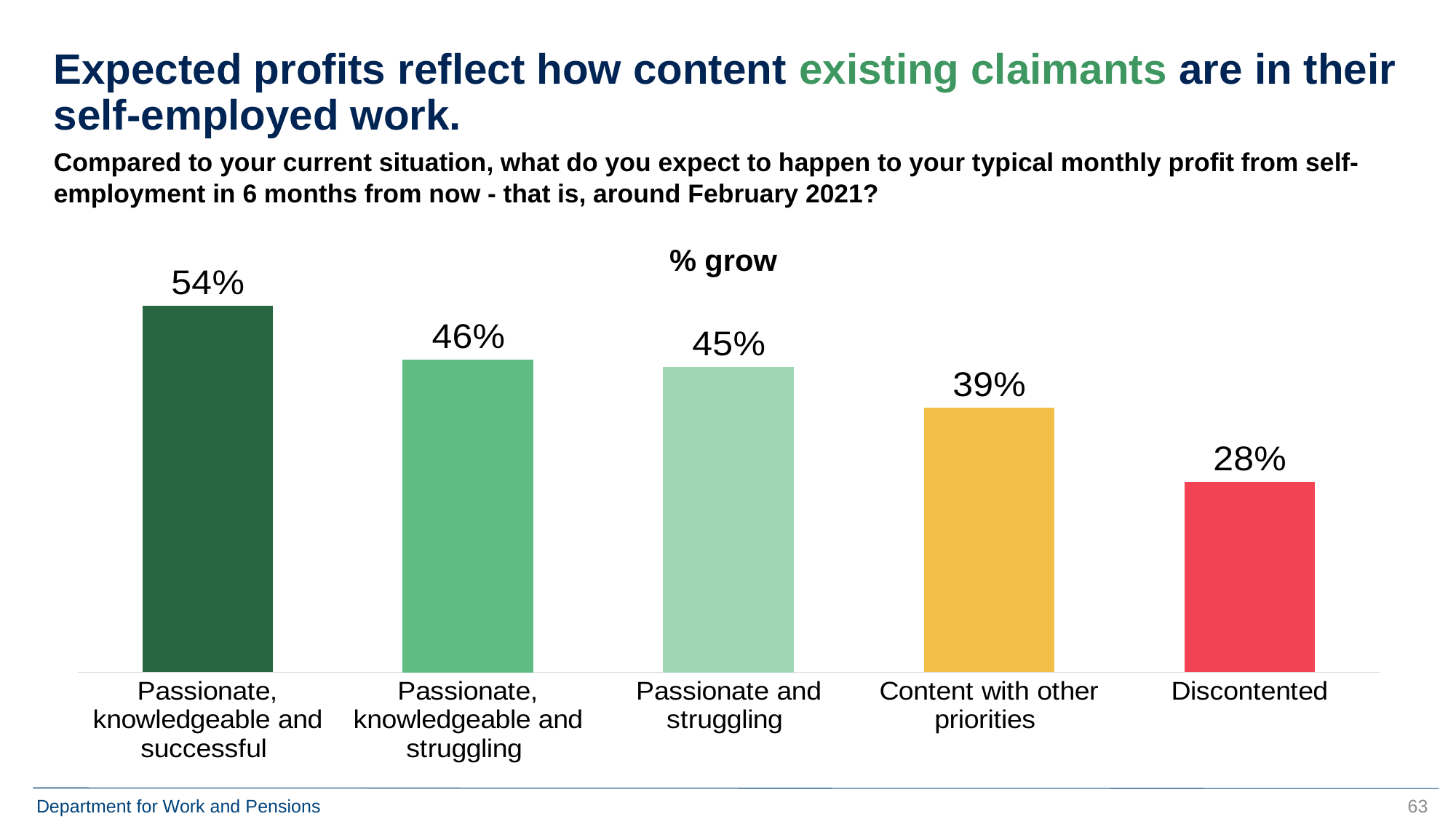
Which is larger, the value for 'Content with other priorities' or the value for 'Discontented'? Content with other priorities What is the value for 'Passionate and struggling'? 45% What is the difference between the values for 'Passionate, knowledgeable and struggling' and 'Content with other priorities'? 7% What is the difference between the values for 'Passionate, knowledgeable and successful' and 'Discontented'? 26% What is the title of the chart? % grow Which category has the lowest value? Discontented What is the value for 'Content with other priorities'? 39% What is the value for 'Discontented'? 28% What kind of chart is shown on the slide? Bar chart What is the value for 'Passionate, knowledgeable and successful'? 54% How many categories are shown in the chart? 5 Which category has the highest value? Passionate, knowledgeable and successful